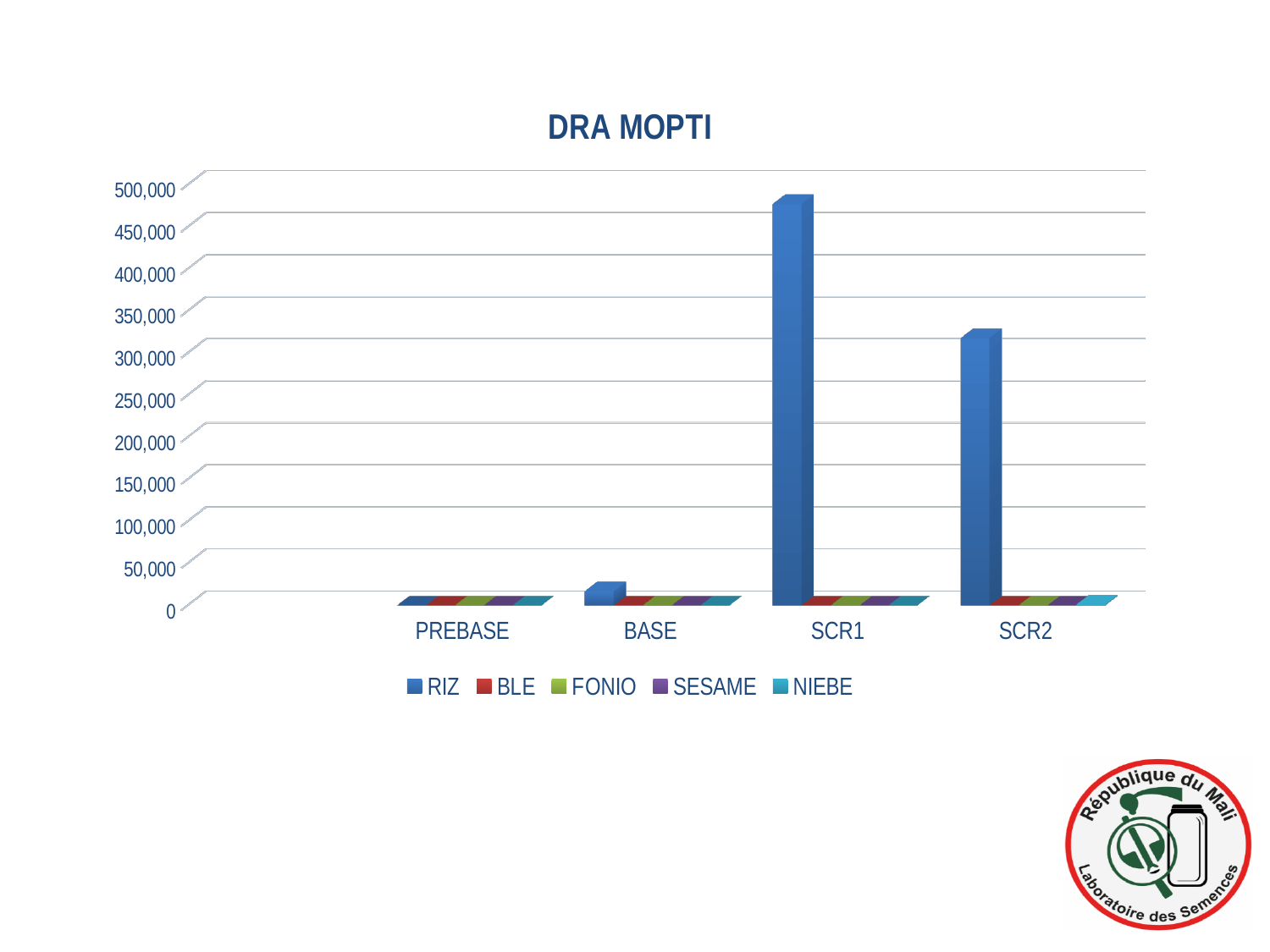
What is the title of the chart? DRA MOPTI How many categories are shown on the x axis? 4 How many series does the legend list? 5 Is the RIZ value for SCR1 greater or less than 450,000? greater Is the RIZ value for SCR2 greater or less than 300,000? greater Which series is shown in blue in the legend? RIZ Which category has the highest RIZ value? SCR1 Which is larger, the RIZ value for BASE or the RIZ value for SCR2? SCR2 Which is larger, the RIZ value for SCR1 or the RIZ value for SCR2? SCR1 Is the RIZ value for BASE greater or less than 50,000? less What kind of chart is shown on the slide? bar chart